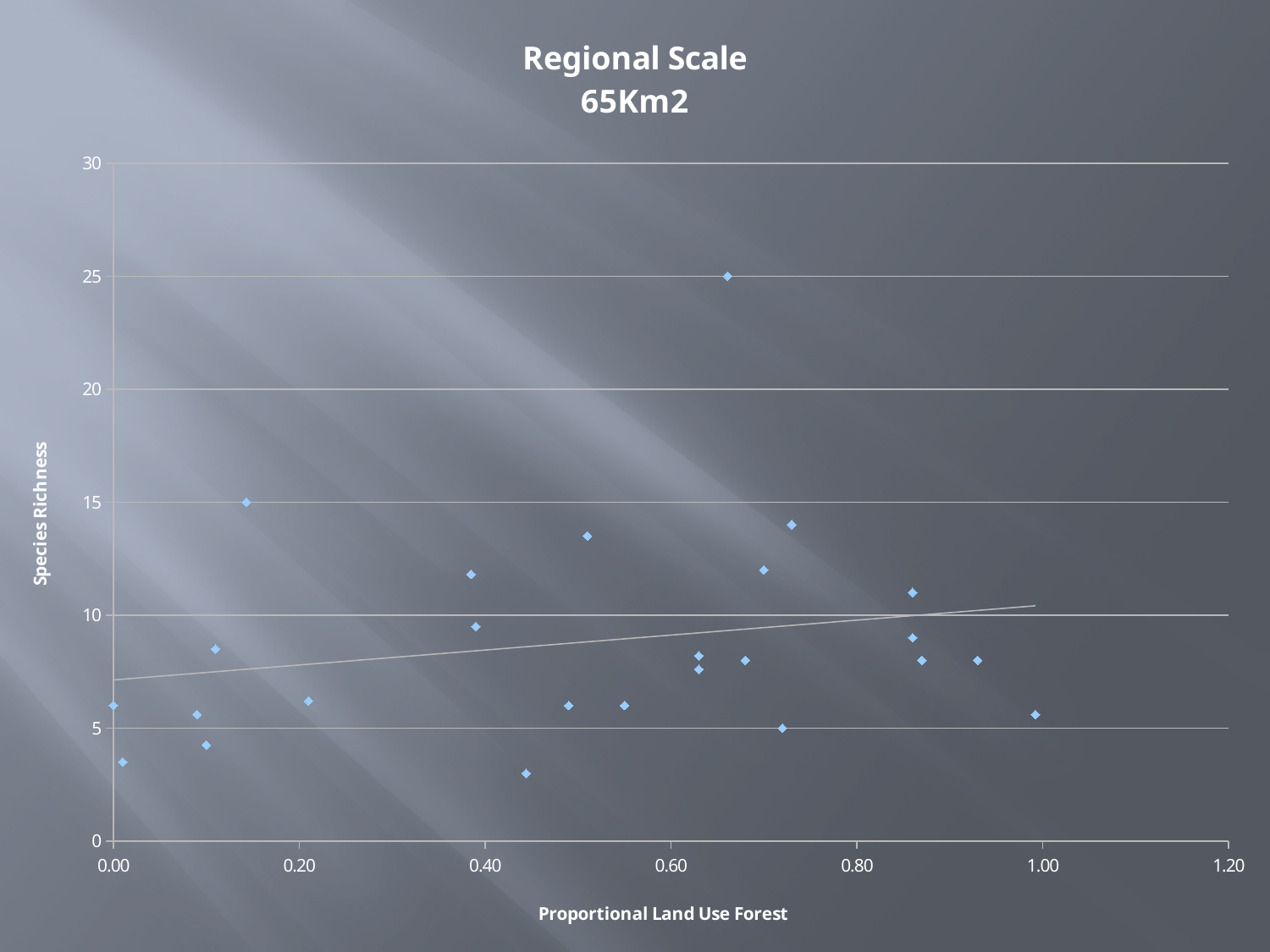
What is the title of the chart? Regional Scale 65Km2 Is the Species Richness value of the point near Proportional Land Use Forest 0.73 greater or less than 10? greater Which is larger: the Species Richness of the point near 0.66 on the x axis or the point near 0.14 on the x axis? the point near 0.66 Does the trendline rise or fall as Proportional Land Use Forest increases? rises What is the label of the horizontal axis? Proportional Land Use Forest What kind of chart is shown on the slide? scatter chart What is the highest Species Richness value plotted on the chart? 25 Is the Species Richness value of the point at Proportional Land Use Forest 0.00 greater or less than 10? less Is the highest plotted Species Richness value greater or less than 20? greater